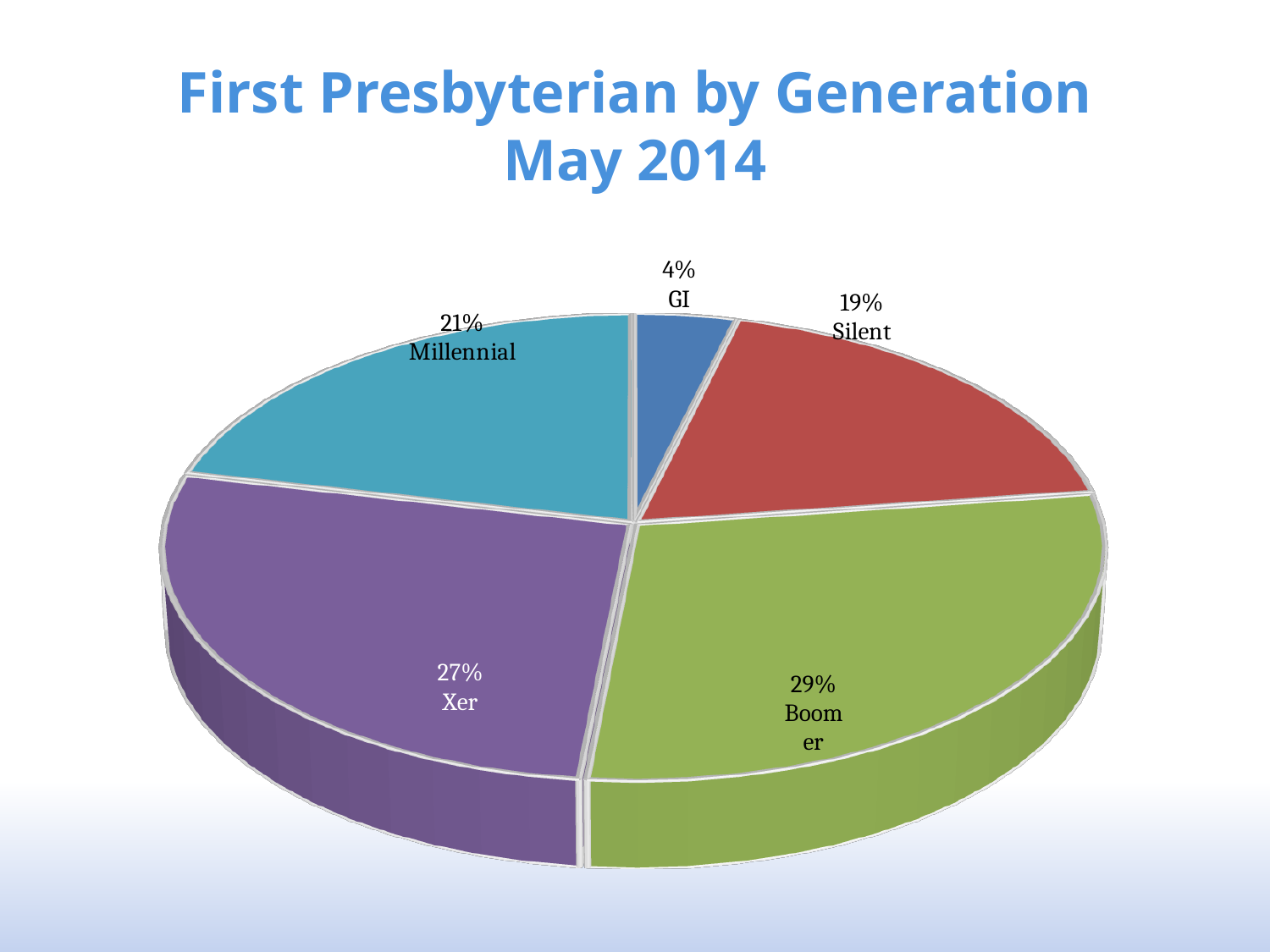
How many generations are shown in the pie chart? 5 What share of the pie does the Boomer slice represent? 29% Which slice is larger, Millennial or Silent? Millennial Which generation has the largest share of the pie? Boomer What percentage is shown for the Millennial generation? 21% What is the combined share of the Xer and Boomer slices? 56% What percentage is shown for the Silent generation? 19% What is the difference in percentage points between the Xer and Silent slices? 8 Which generation has the smallest share of the pie? GI What is the title of the chart? First Presbyterian by Generation May 2014 What kind of chart is shown on the slide? Pie chart What colour is the Xer slice? Purple